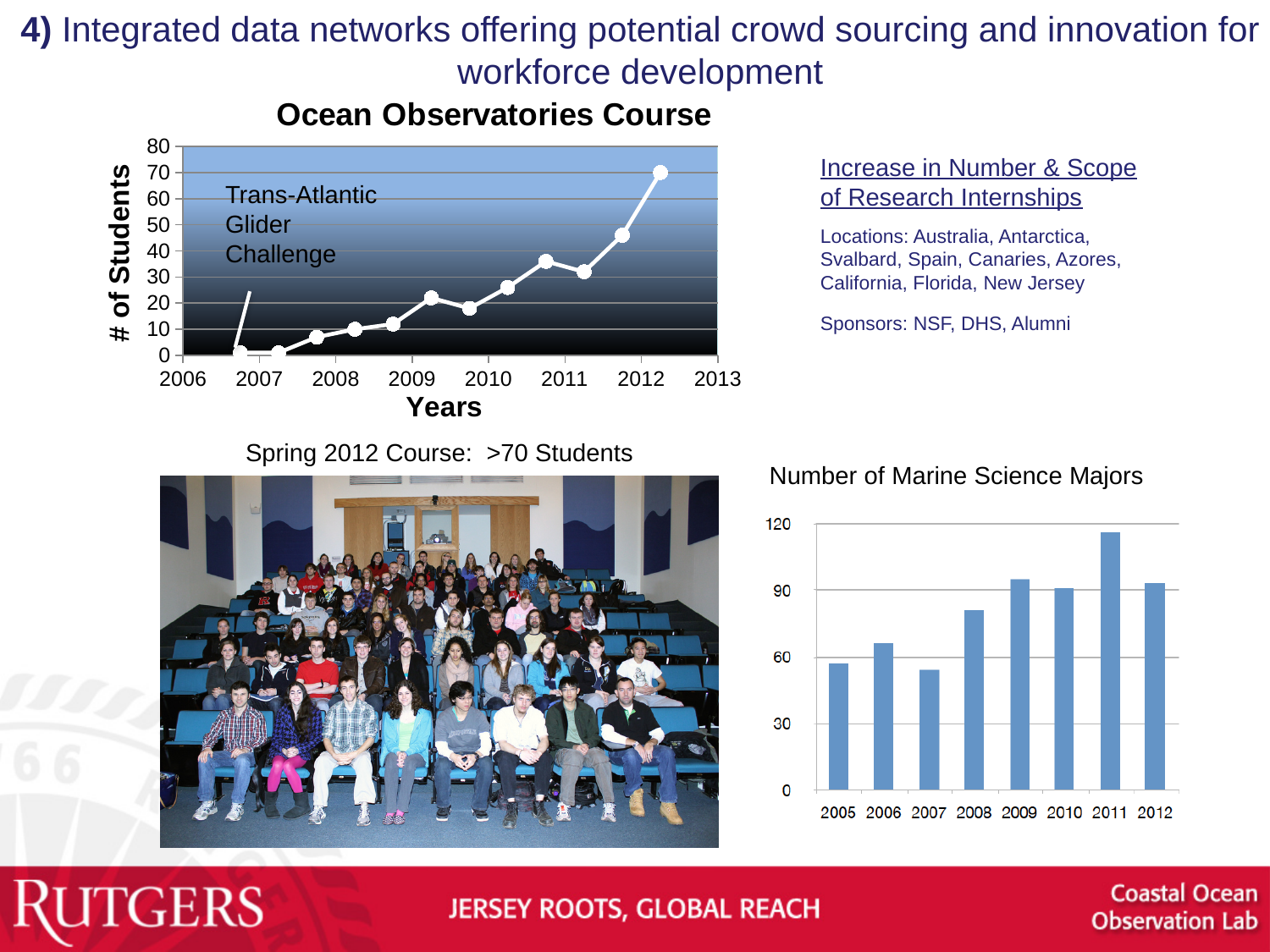
What type of chart is the "Number of Marine Science Majors" chart? bar chart In the "Number of Marine Science Majors" chart, is the value for 2008 greater or less than 60? greater In the "Ocean Observatories Course" chart, is the highest plotted value greater or less than 60? greater What type of chart is the "Ocean Observatories Course" chart? line chart In the "Number of Marine Science Majors" chart, is the value for 2011 greater or less than 90? greater In the "Ocean Observatories Course" chart, do the number of students generally rise or fall from 2007 to 2012? rise In the "Number of Marine Science Majors" chart, which is larger, the value for 2009 or the value for 2006? 2009 In the "Ocean Observatories Course" chart, what is the label of the x axis? Years In the "Number of Marine Science Majors" chart, how many years are shown on the x axis? 8 In the "Number of Marine Science Majors" chart, which year has the highest number of majors? 2011 In the "Ocean Observatories Course" chart, what is the label of the y axis? # of Students